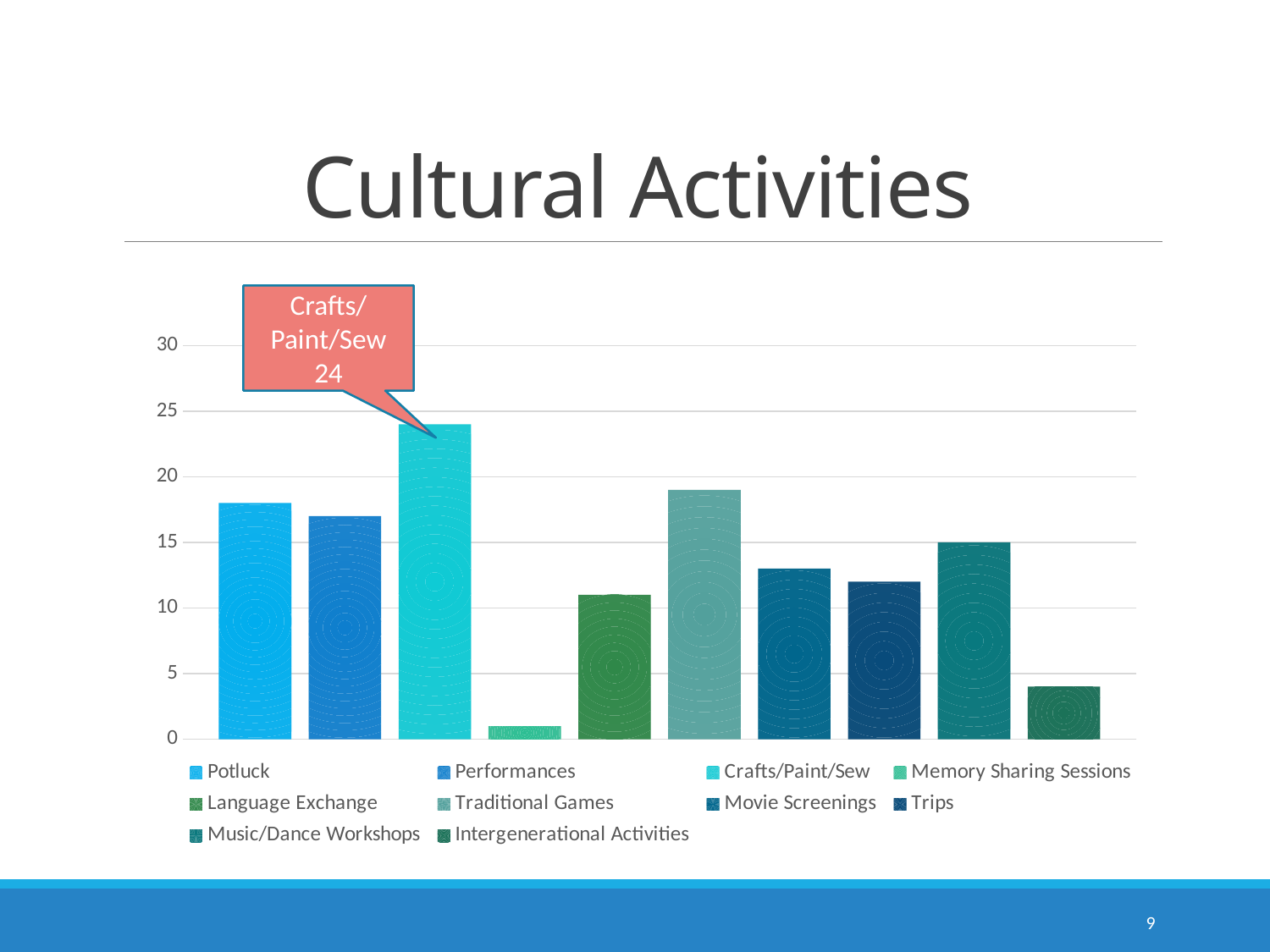
Is the value for Trips greater or less than 10? greater Which is larger, Traditional Games or Movie Screenings? Traditional Games Which category has the highest bar? Crafts/Paint/Sew Which category has the lowest bar? Memory Sharing Sessions What is the value for Crafts/Paint/Sew? 24 Is the value for Potluck greater or less than 15? greater What kind of chart is shown on the slide? Bar chart Is the value for Intergenerational Activities greater or less than 5? less How many entries does the legend list? 10 Which is larger, Language Exchange or Potluck? Potluck How many bars are plotted in the chart? 10